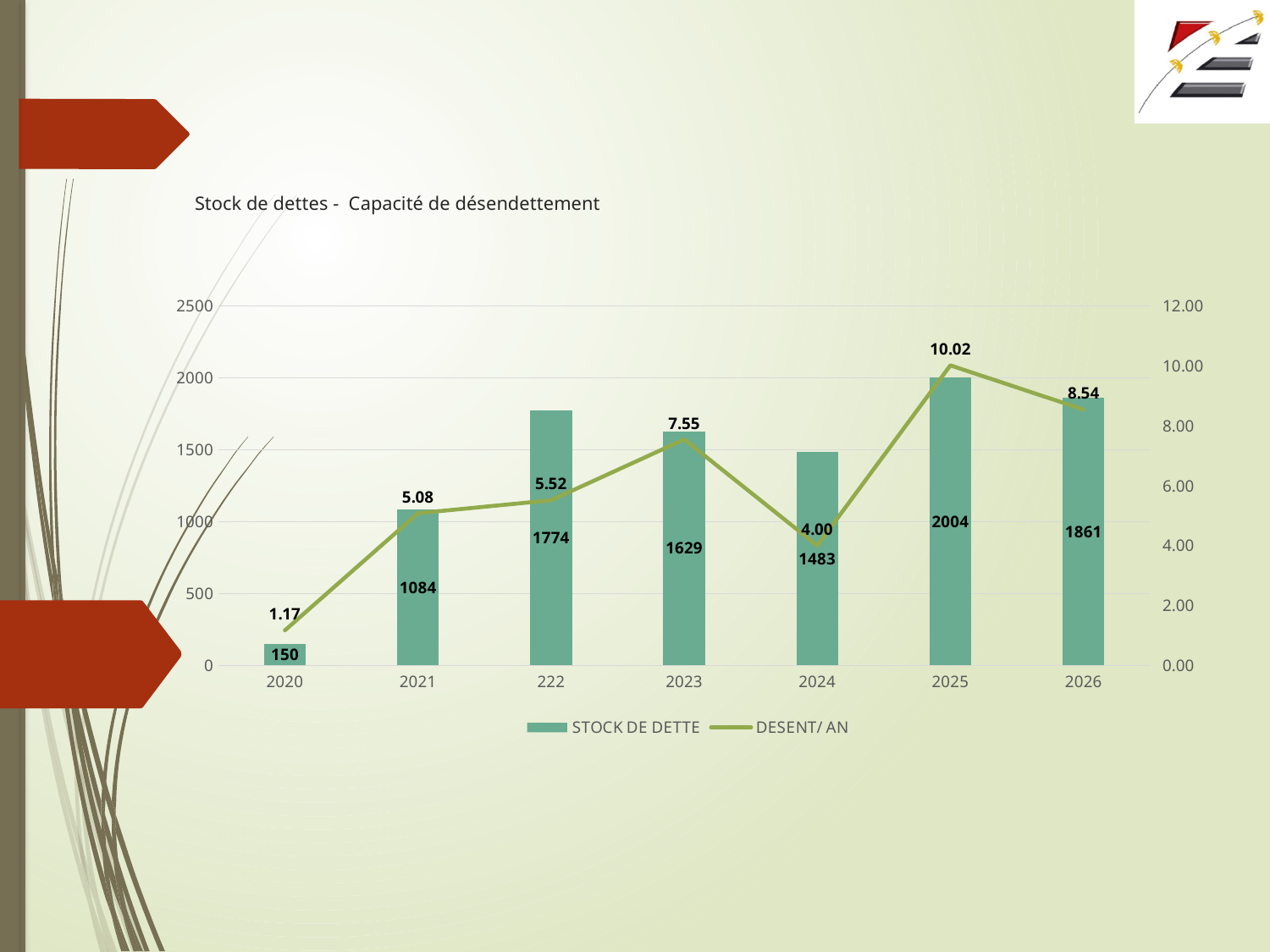
How many years are shown on the x axis? 7 What is the STOCK DE DETTE value for 2021? 1084 Which is larger, the STOCK DE DETTE value for 2023 or for 2024? 2023 What kind of chart is this? Combined bar and line chart What is the DESENT/ AN value for 2020? 1.17 How many series does the legend list? 2 Which year has the lowest DESENT/ AN value? 2020 What is the difference between the STOCK DE DETTE values for 2025 and 2026? 143 What is the title of the chart? Stock de dettes - Capacité de désendettement What is the DESENT/ AN value for 2025? 10.02 Which year has the highest STOCK DE DETTE value? 2025 What is the STOCK DE DETTE value for 2024? 1483